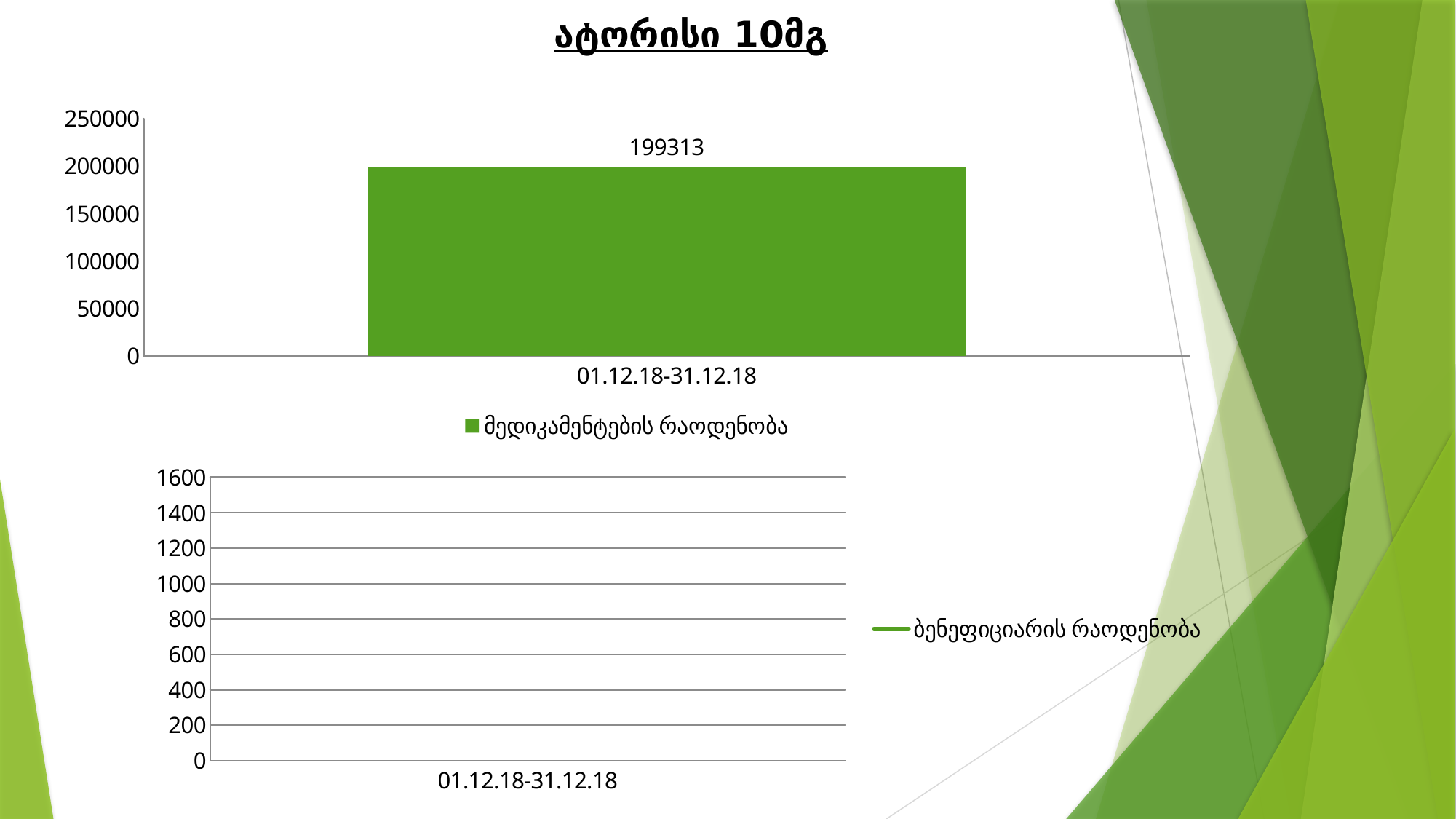
In the top chart, is the value for 01.12.18-31.12.18 greater or less than 200000? less What is the legend entry of the top chart? მედიკამენტების რაოდენობა What kind of chart is the top chart on the slide? bar chart What is the highest tick value on the y axis of the bottom chart? 1600 How many series does the legend of the top chart list? 1 In the top chart, what is the value of the bar for 01.12.18-31.12.18? 199313 In the top chart, is the value for 01.12.18-31.12.18 greater or less than 150000? greater How many bars are plotted in the top chart? 1 What is the category label on the x axis of the bottom chart? 01.12.18-31.12.18 What is the highest tick value on the y axis of the top chart? 250000 How many series does the legend of the bottom chart list? 1 What is the category label on the x axis of the top chart? 01.12.18-31.12.18